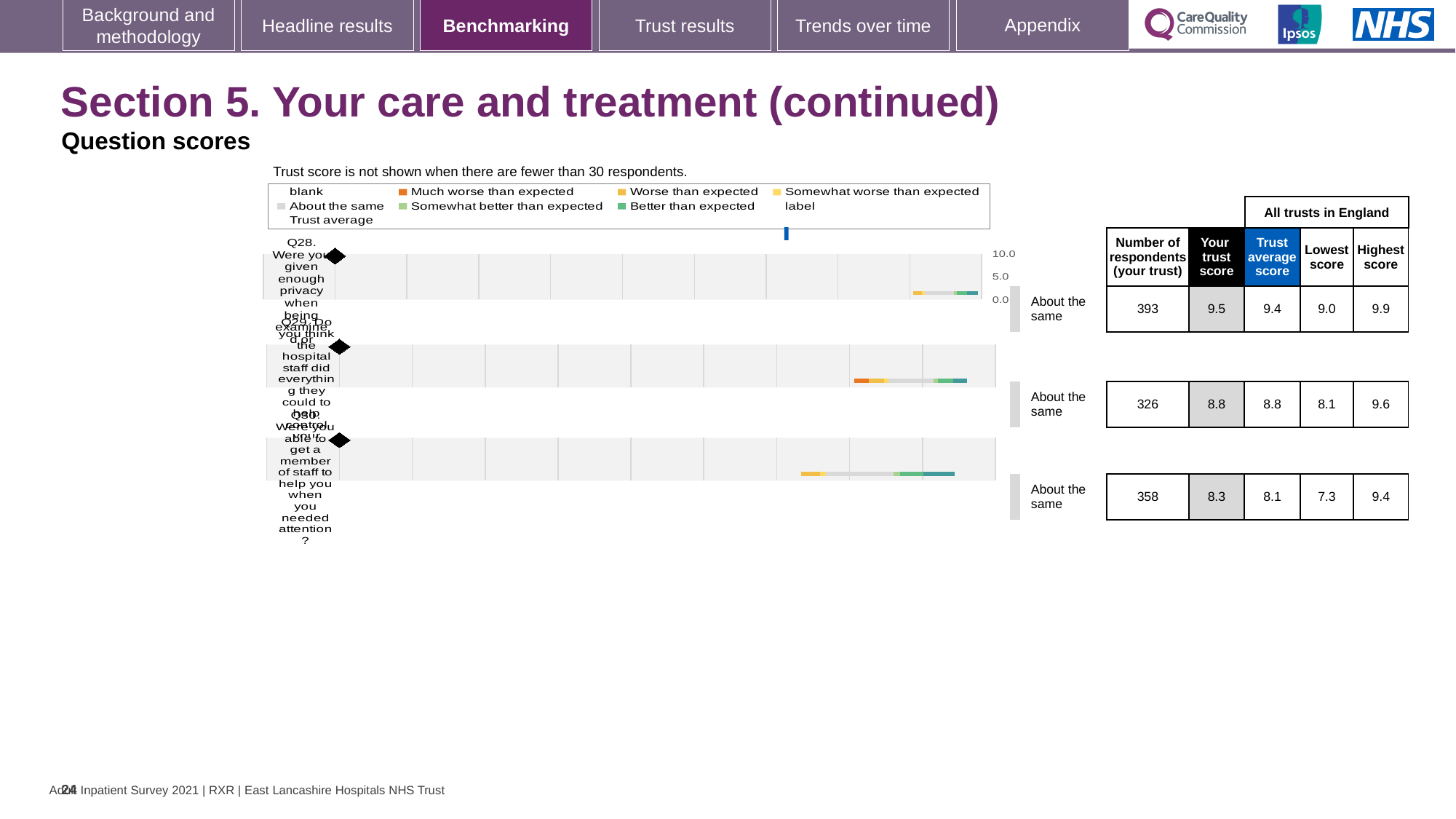
For Q30, which is larger: the trust score or the trust average score? trust score (8.3) Which question has the highest trust score? Q28 What benchmark category is shown for all three questions on this slide? About the same Is the trust score for Q29 greater or less than 5.0? greater What is the difference between the trust score and the trust average score for Q28? 0.1 What is the trust score for Q28 (Were you given enough privacy when being examined or treated)? 9.5 What is the highest score across all trusts in England for Q30? 9.4 How many questions are plotted in the question scores chart? 3 What kind of chart is used to show the question scores on this slide? bar chart What is the difference between the highest and lowest scores across all trusts for Q29? 1.5 How many respondents answered Q29 for this trust? 326 Which question has the lowest trust score? Q30